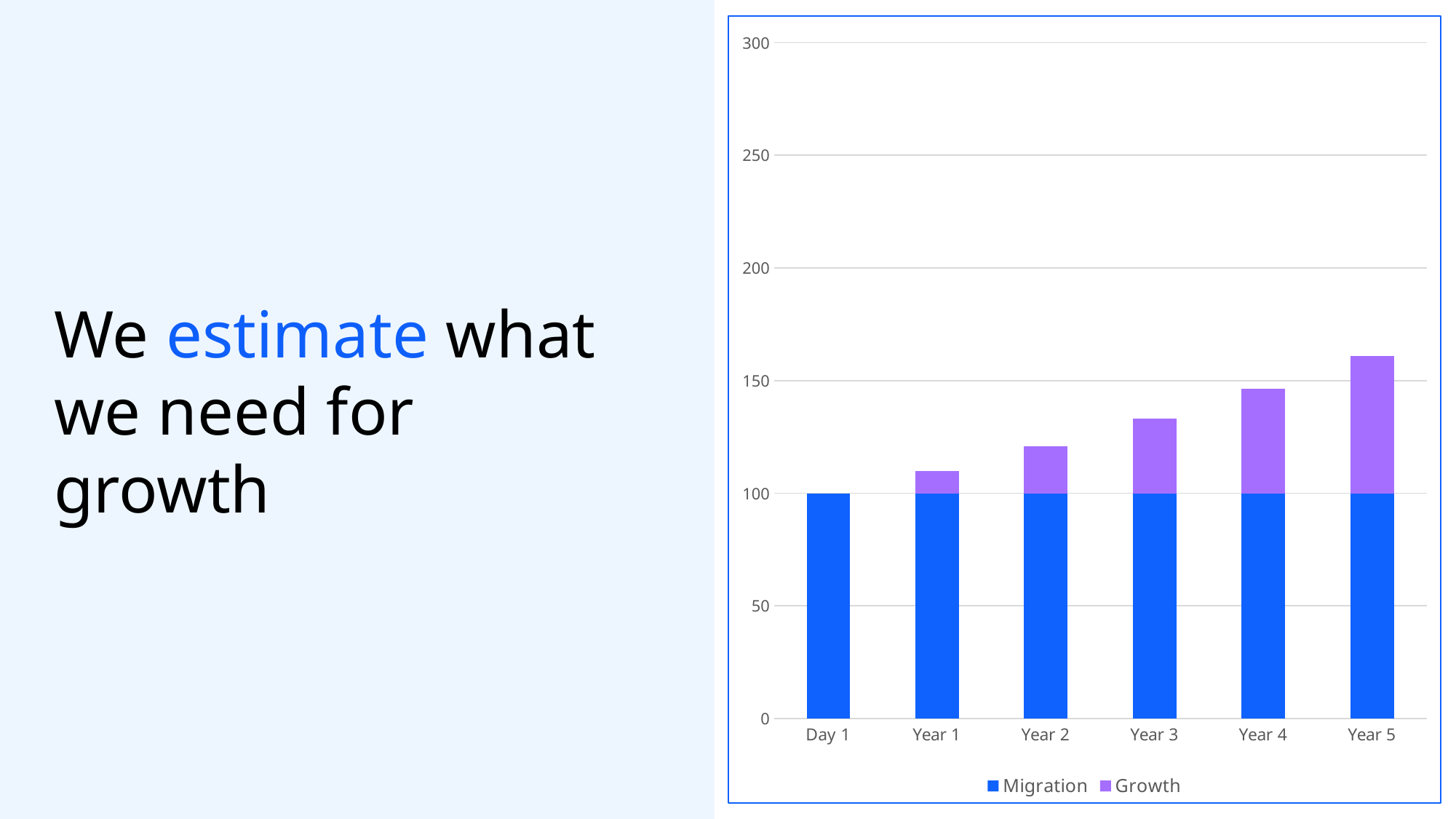
Which category has the tallest stacked bar? Year 5 Which stacked bar is taller, Year 2 or Year 4? Year 4 What is the Migration value for Day 1? 100 How many categories are shown on the x axis of the chart? 6 What are the two series named in the chart's legend? Migration and Growth Is the total value for Year 3 greater or less than 150? less Do the total bar heights rise or fall from Day 1 to Year 5? rise What is the total height of the Day 1 bar? 100 Is the total value for Year 5 greater or less than 150? greater Which category has the shortest stacked bar? Day 1 What kind of chart is shown on the slide? bar chart How many series does the chart's legend list? 2